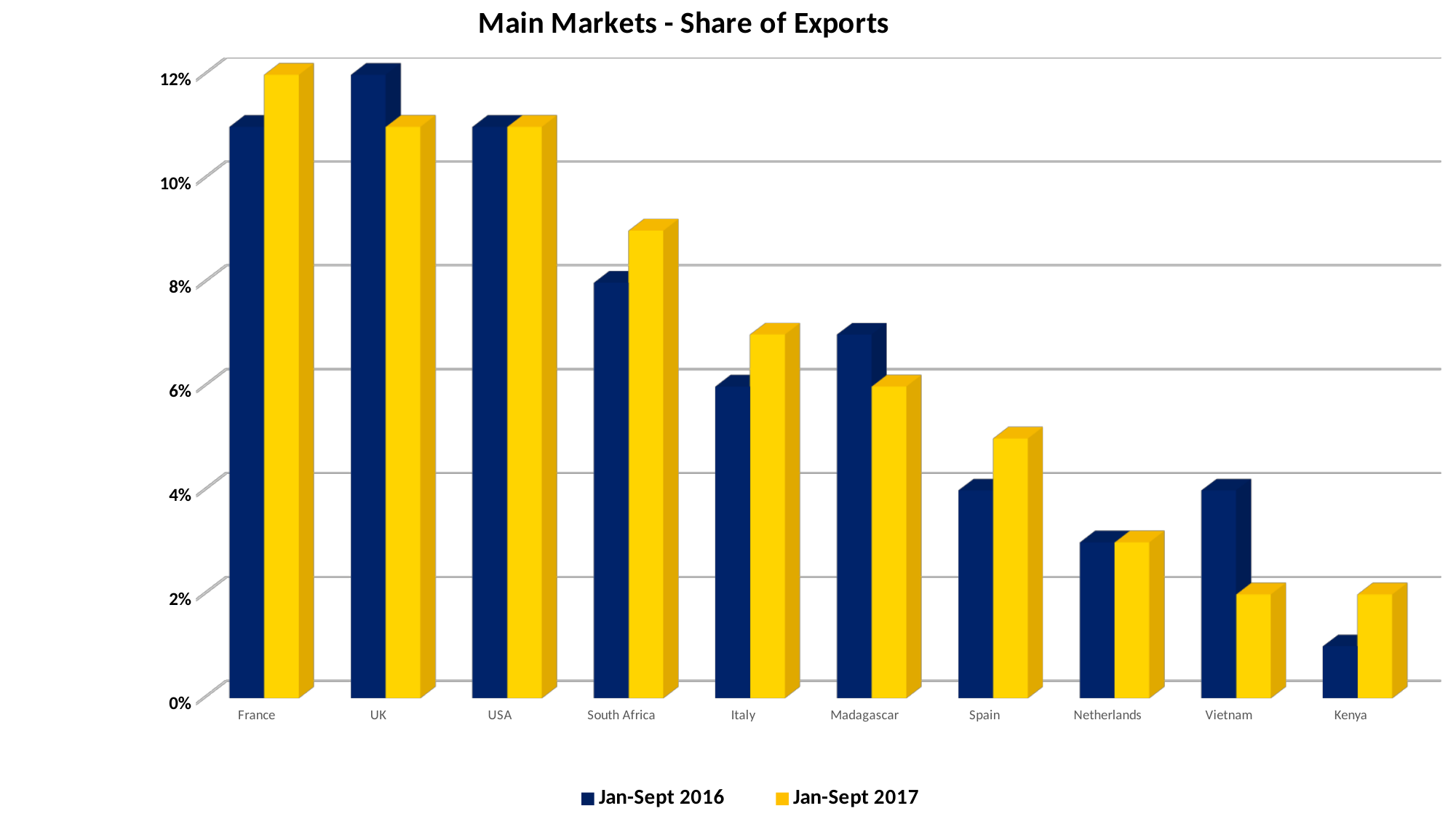
Is the Jan-Sept 2017 value for Vietnam greater or less than 4%? less Which country has the highest share of exports for Jan-Sept 2016? UK Which series is shown in yellow in the legend? Jan-Sept 2017 For South Africa, which is larger: the Jan-Sept 2016 value or the Jan-Sept 2017 value? Jan-Sept 2017 Is the Jan-Sept 2016 value for France greater or less than 10%? greater For Madagascar, which is larger: the Jan-Sept 2016 value or the Jan-Sept 2017 value? Jan-Sept 2016 What kind of chart is shown on the slide? Bar chart Which country has the lowest share of exports for Jan-Sept 2016? Kenya How many countries are shown on the x axis? 10 Which country has the highest share of exports for Jan-Sept 2017? France What is the title of the chart? Main Markets - Share of Exports How many series does the legend list? 2